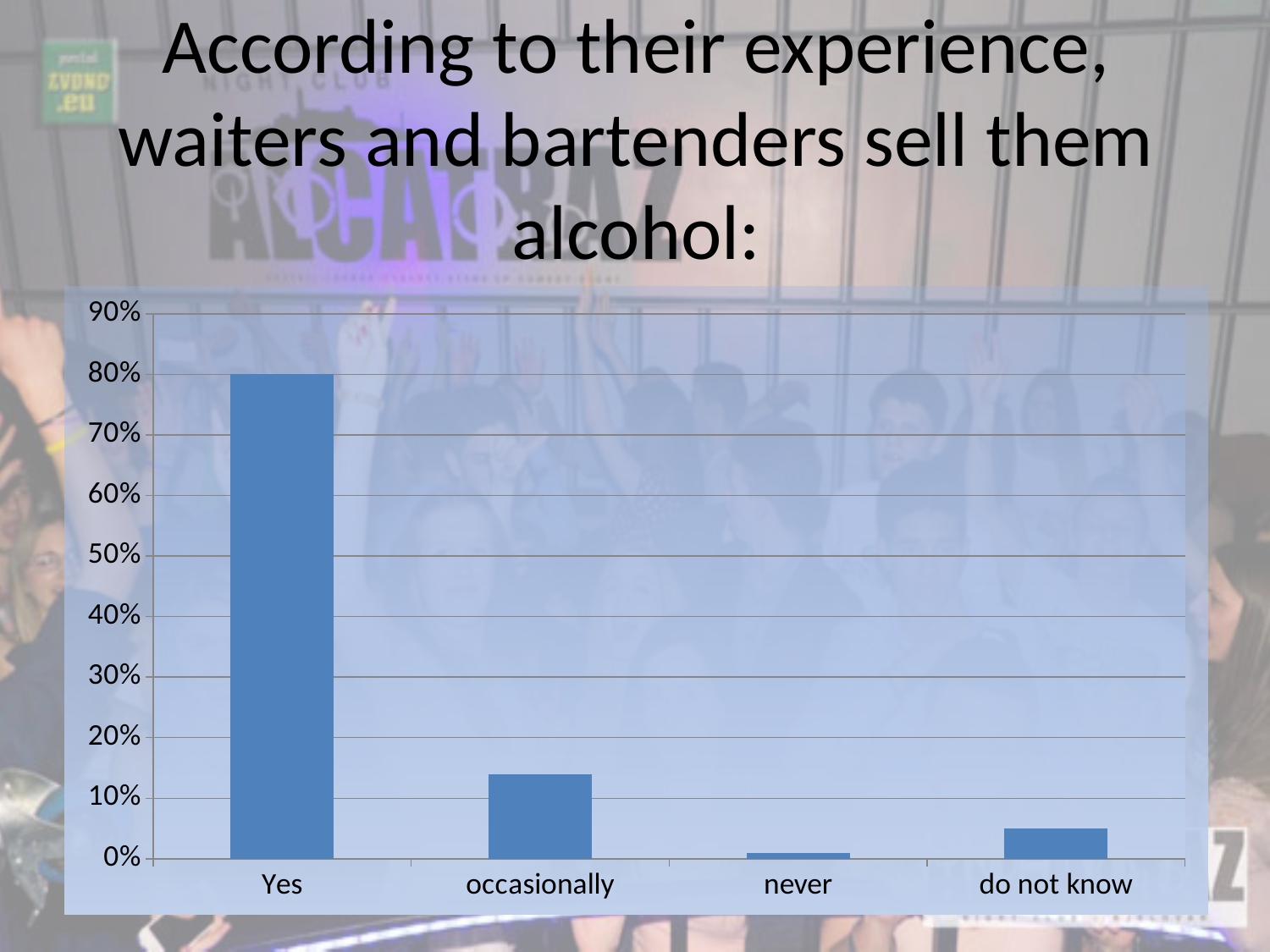
How many categories are shown on the x axis of the chart? 4 Which category has the lowest value in the chart? never Is the value for "never" greater or less than 10%? less What is the value for "Yes" in the chart? 80% Is the value for "occasionally" greater or less than 20%? less Is the value for "occasionally" greater or less than 10%? greater Which category has the highest value in the chart? Yes What kind of chart is shown on the slide? bar chart Which is larger, the value for "Yes" or the value for "never"? Yes Which is larger, the value for "occasionally" or the value for "do not know"? occasionally What is the highest value shown on the y axis of the chart? 90%